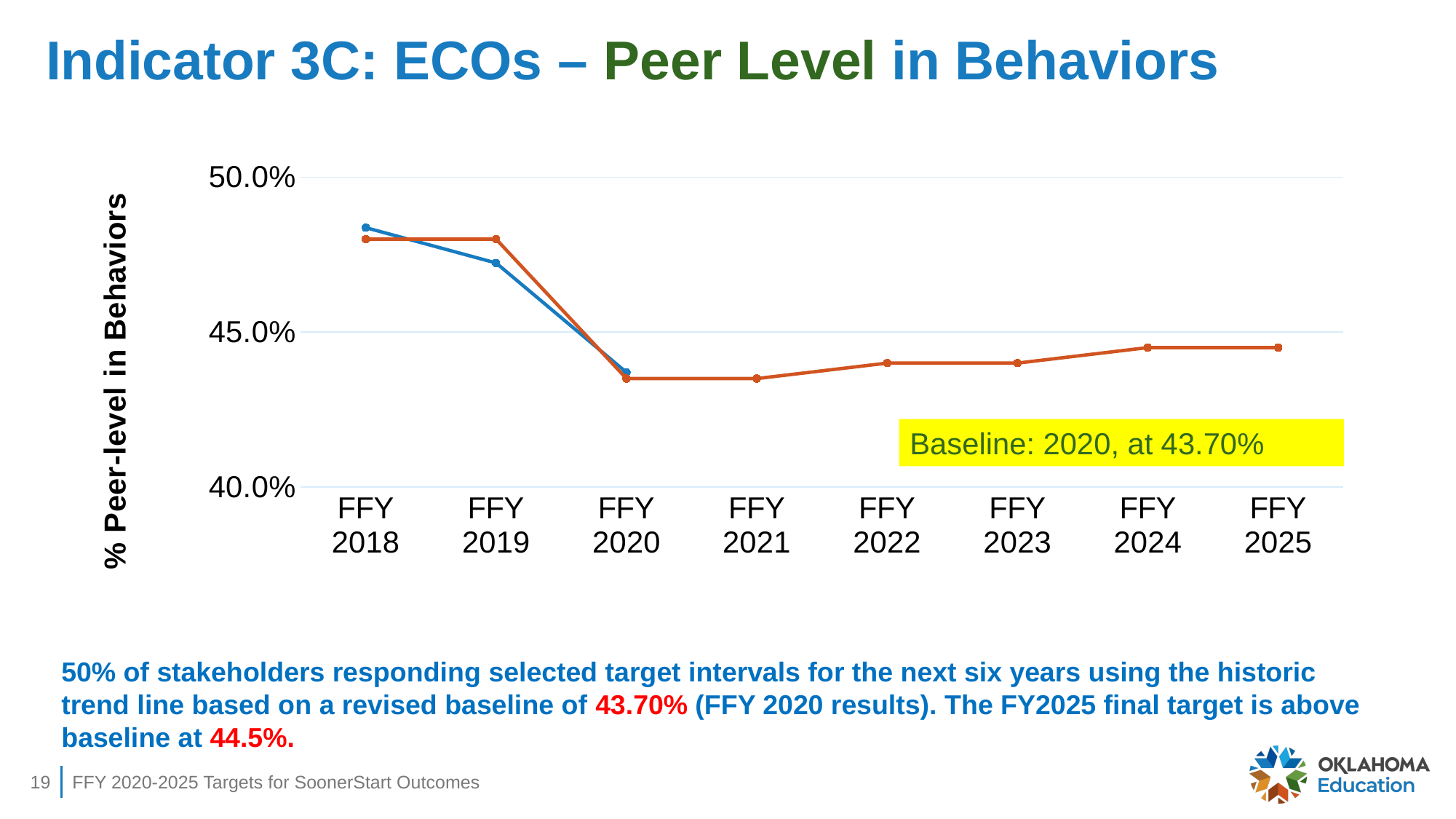
What is the FY2025 final target value stated on the slide? 44.5% Do the values rise or fall from FFY 2021 to FFY 2025? rise Which is larger, the value for FFY 2018 or the value for FFY 2020? FFY 2018 Is the value for FFY 2021 greater or less than 45.0%? less What is the title of the y axis of the chart? % Peer-level in Behaviors How many FFY categories are shown on the x axis of the chart? 8 How many lines are plotted on the chart? 2 Do the values rise or fall from FFY 2018 to FFY 2020? fall Is the value for FFY 2025 greater or less than 45.0%? less What is the baseline value for 2020 stated on the chart? 43.70% Is the value for FFY 2018 greater or less than 45.0%? greater What kind of chart is shown on the slide? line chart